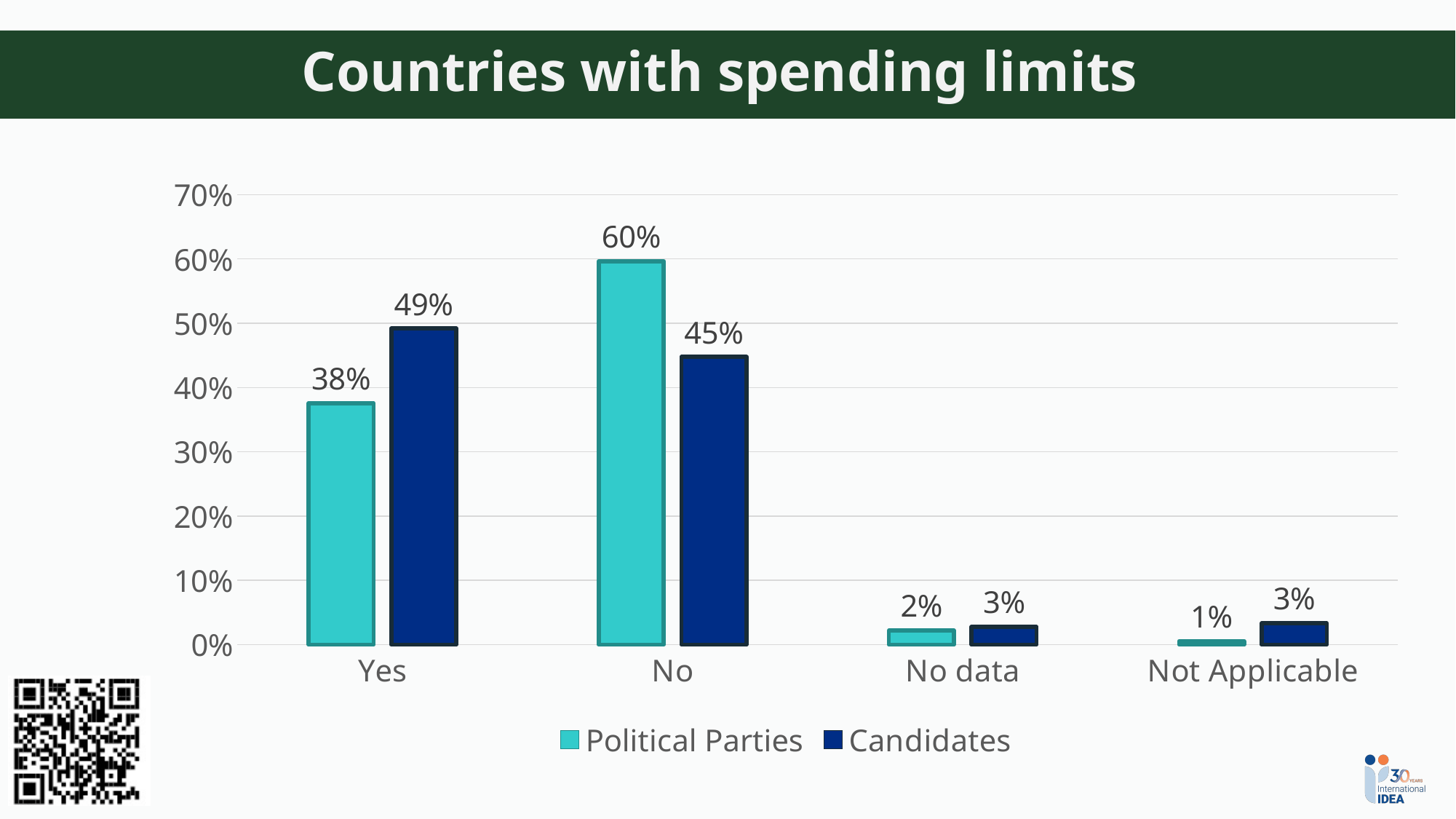
Is the value for Candidates in the Yes category greater or less than 40%? greater What kind of chart is shown on the slide? Bar chart What is the difference between the Political Parties and Candidates values in the No category? 15% In the Yes category, which series has the larger value, Political Parties or Candidates? Candidates What is the value for Political Parties in the Not Applicable category? 1% What is the value for Political Parties in the Yes category? 38% How many series does the legend list? 2 Which category has the lowest value for Candidates? No data and Not Applicable (both 3%) What is the value for Candidates in the No category? 45% What is the title of the chart? Countries with spending limits Which category has the highest value for Political Parties? No How many categories are shown on the x axis? 4